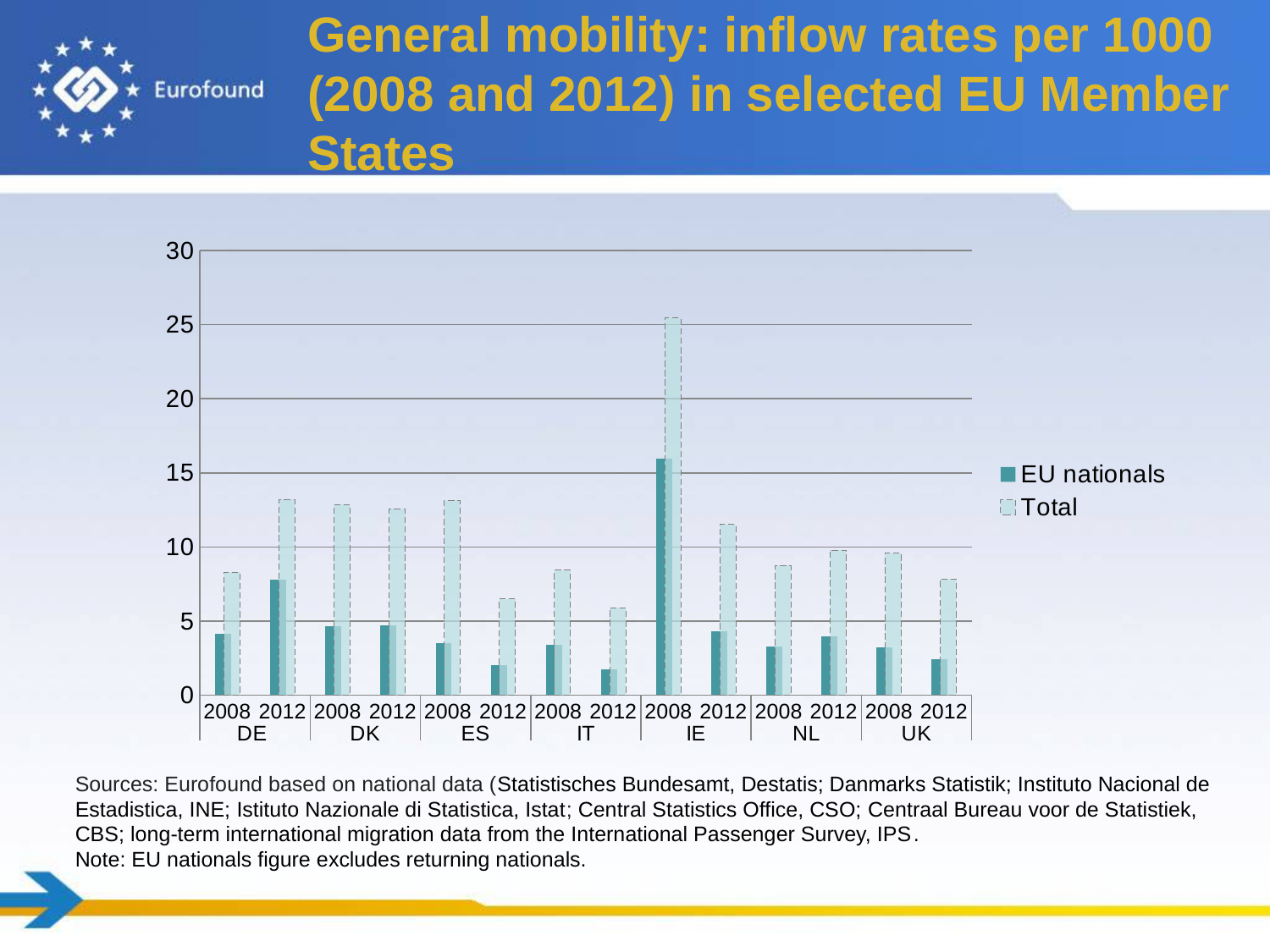
How many countries are shown on the x axis of the chart? 7 Which country and year has the highest Total inflow rate? IE 2008 Is the EU nationals value for IE in 2008 greater or less than 15? greater What are the two entries listed in the chart legend? EU nationals and Total Is the Total value for DE in 2012 greater or less than 10? greater How many series does the legend list? 2 For DE, is the Total inflow rate larger in 2008 or in 2012? 2012 Is the EU nationals value for ES in 2012 greater or less than 5? less For ES, is the Total inflow rate larger in 2008 or in 2012? 2008 What kind of chart is shown on the slide? Bar chart Which country and year has the highest EU nationals inflow rate? IE 2008